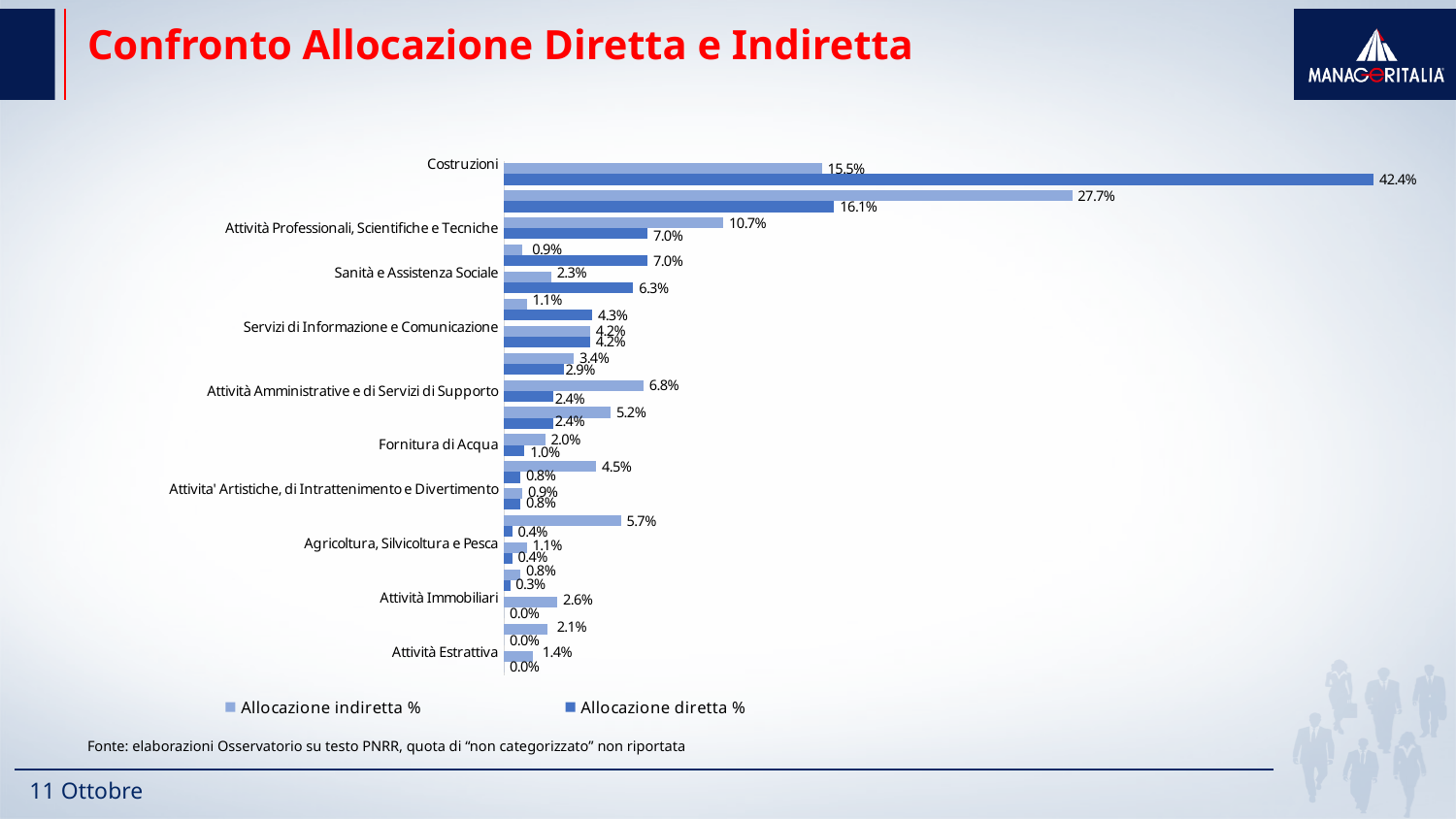
What is the Allocazione indiretta % value for Attività Professionali, Scientifiche e Tecniche? 10.7% What is the Allocazione indiretta % value for Costruzioni? 15.5% What is the Allocazione diretta % value for Attività Immobiliari? 0.0% What is the Allocazione indiretta % value for Attività Amministrative e di Servizi di Supporto? 6.8% How many series does the legend list? 2 Which category has the highest Allocazione diretta % value? Costruzioni What is the Allocazione diretta % value for Sanità e Assistenza Sociale? 6.3% For Sanità e Assistenza Sociale, which is larger: Allocazione indiretta % or Allocazione diretta %? Allocazione diretta % What is the Allocazione diretta % value for Costruzioni? 42.4% What is the difference between the Allocazione diretta % and Allocazione indiretta % values for Costruzioni? 26.9 percentage points What kind of chart is shown on the slide? Bar chart For Attività Amministrative e di Servizi di Supporto, which is larger: Allocazione indiretta % or Allocazione diretta %? Allocazione indiretta %